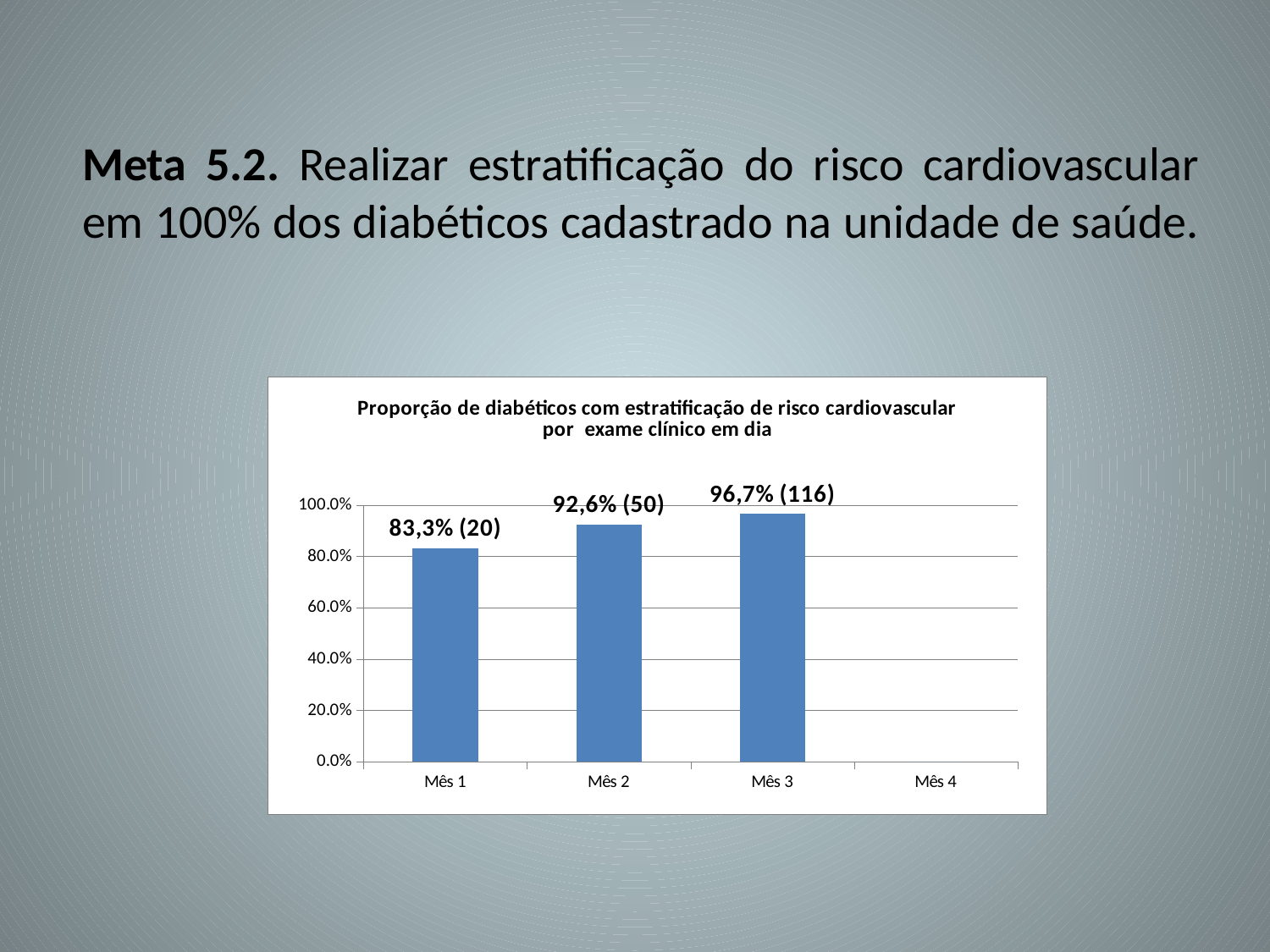
Which is larger, the proportion for Mês 2 or for Mês 3? Mês 3 How many months have a bar plotted on the chart? 3 What is the value shown for Mês 3? 96,7% (116) Do the values rise or fall from Mês 1 to Mês 3? rise Which month with a plotted bar has the lowest proportion? Mês 1 Is the value for Mês 1 greater or less than 80.0%? greater Which month has the highest proportion? Mês 3 What is the difference in percentage points between Mês 2 and Mês 1? 9,3% What is the value shown for Mês 1? 83,3% (20) What is the value shown for Mês 2? 92,6% (50) What kind of chart is shown on the slide? bar chart What is the difference in percentage points between Mês 3 and Mês 1? 13,4%